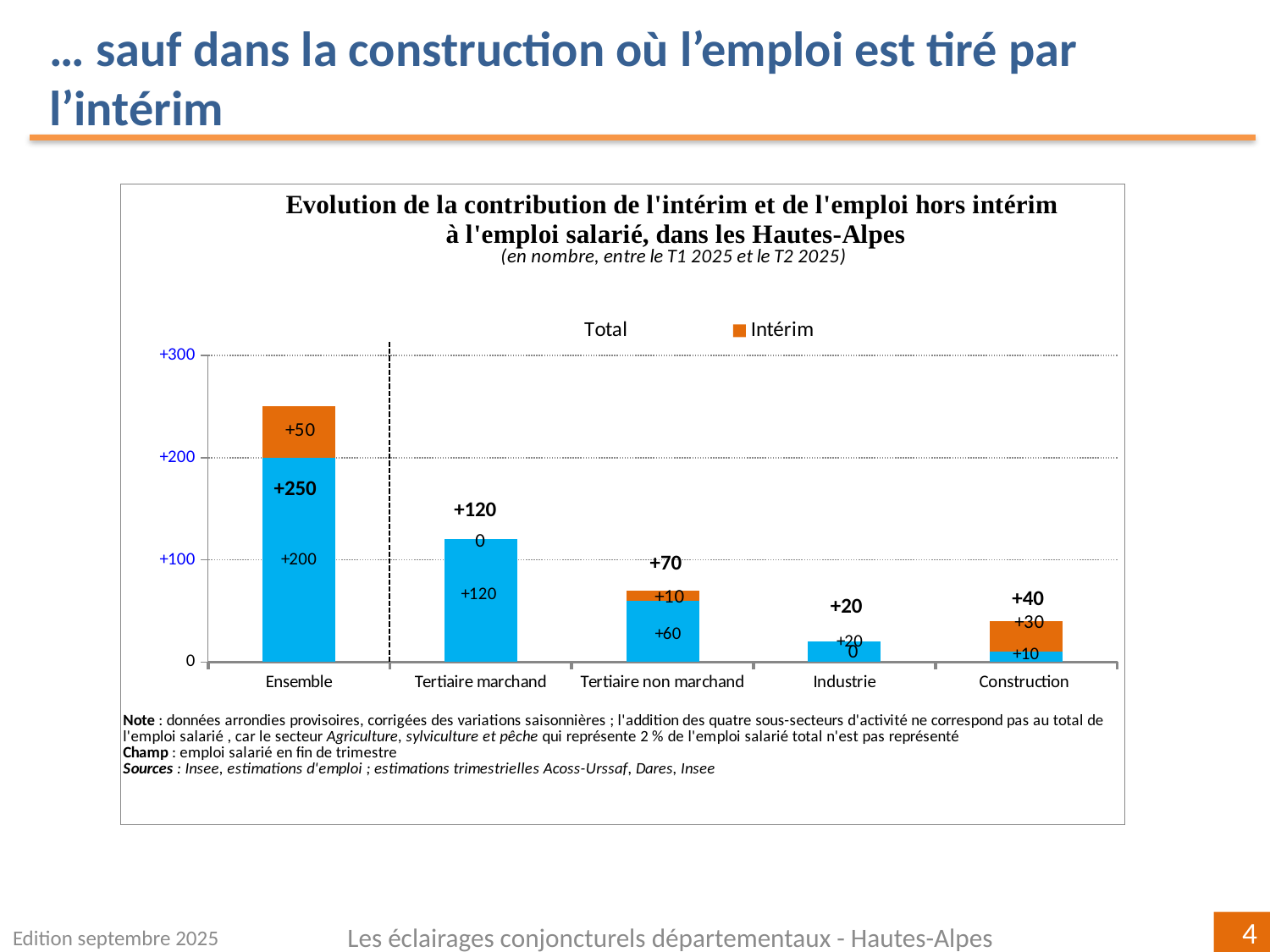
Is the total value for Ensemble greater or less than +200? greater Which category has the lowest total value? Industrie What is the Intérim value for Construction? +30 What is the difference between the total for Tertiaire marchand and the total for Construction? 80 What is the total value shown for Tertiaire non marchand? +70 What is the Intérim value for Ensemble? +50 What is the Intérim value for Tertiaire marchand? 0 How many categories are shown on the x axis? 5 Is the Intérim value larger for Construction or for Tertiaire non marchand? Construction What is the total value shown for Ensemble? +250 What kind of chart is this? Stacked bar chart Which category has the highest total value? Ensemble